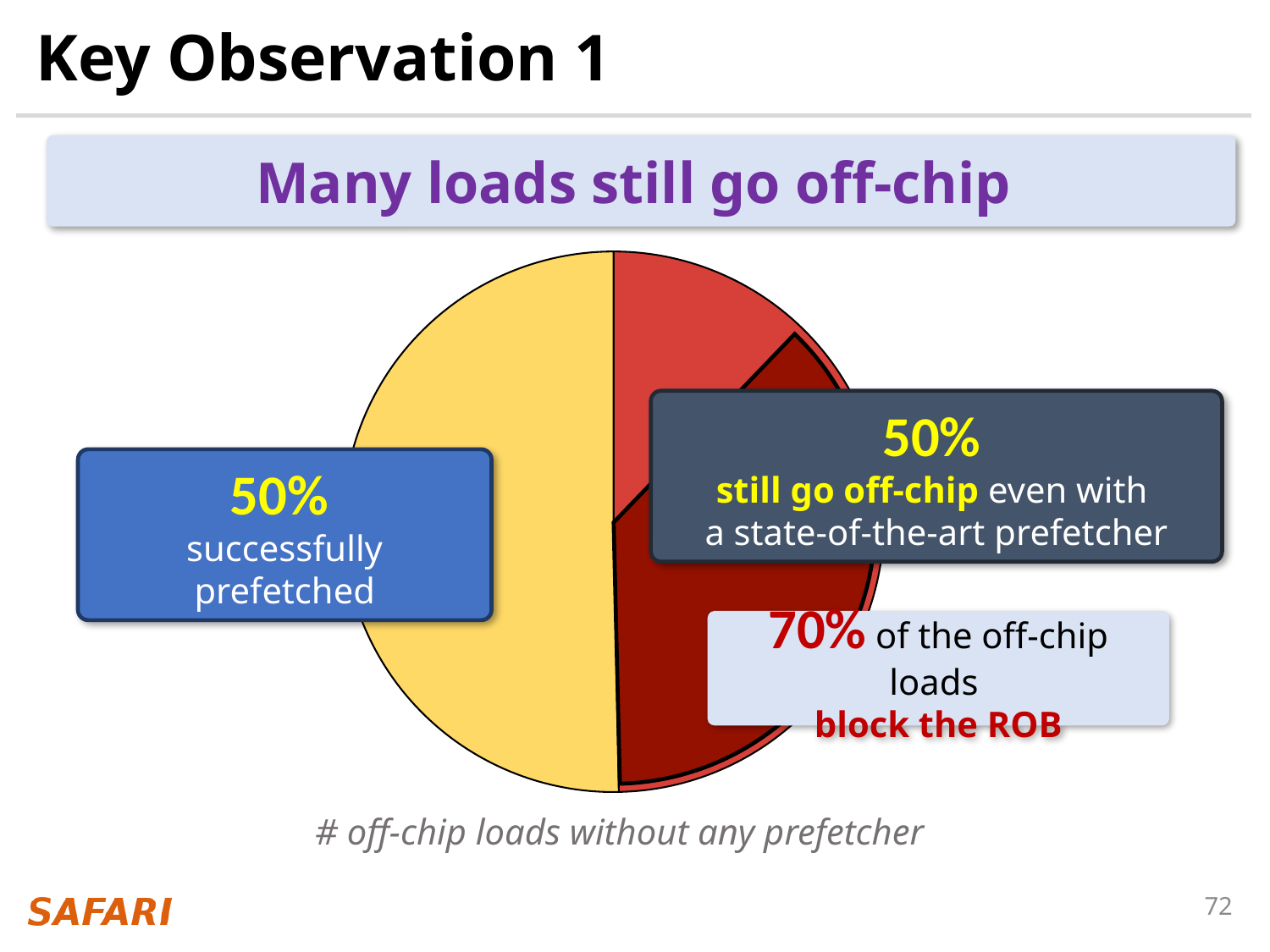
What percentage of the off-chip loads block the ROB? 70% What does the caption below the pie chart say the chart represents? # off-chip loads without any prefetcher What is the main message stated in the banner above the pie chart? Many loads still go off-chip Is the share of off-chip loads that block the ROB greater or less than 50%? greater Is the share of loads that are successfully prefetched larger or smaller than the share that still go off-chip? equal What kind of chart is shown on the slide? pie chart What share of loads still go off-chip even with a state-of-the-art prefetcher? 50% What is the combined share of loads successfully prefetched and loads that still go off-chip? 100% What share of off-chip loads is successfully prefetched according to the pie chart? 50% Which colour represents the loads that are successfully prefetched in the pie chart? yellow What is the difference between the share of loads successfully prefetched and the share that still go off-chip? 0%